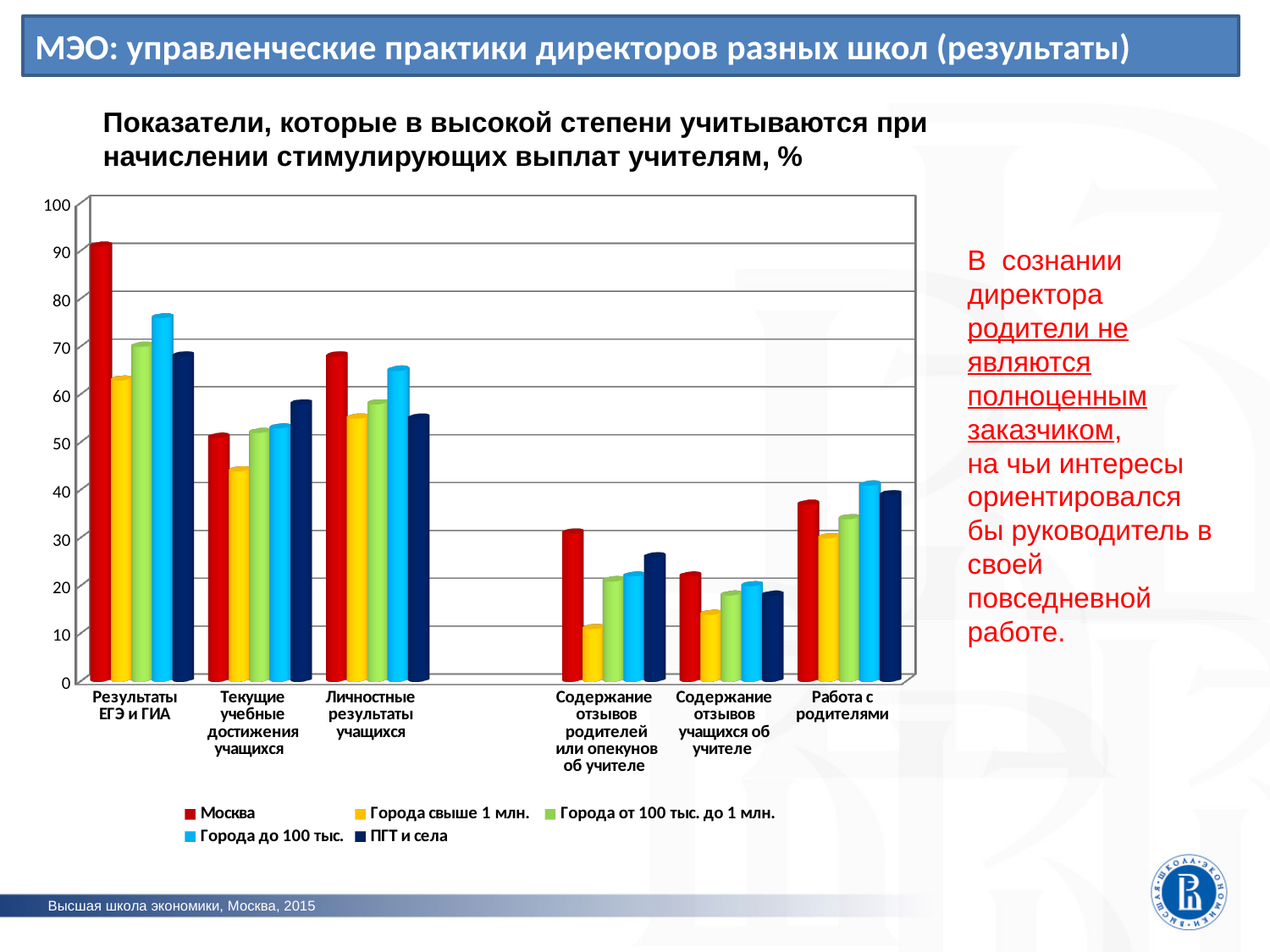
What kind of chart is shown on the slide? bar chart How many series does the legend list? 5 For which category is the value for Москва the lowest? Содержание отзывов учащихся об учителе Is the value for Москва in the category Результаты ЕГЭ и ГИА greater or less than 80? greater In the category Результаты ЕГЭ и ГИА, which series has the lowest value? Города свыше 1 млн. Is the value for Города свыше 1 млн. in the category Содержание отзывов родителей или опекунов об учителе greater or less than 20? less What colour represents the series Москва in the legend? red In the category Текущие учебные достижения учащихся, which series has the highest value? ПГТ и села In the category Работа с родителями, which is larger: the value for Города до 100 тыс. or the value for Города свыше 1 млн.? Города до 100 тыс. Is the value for ПГТ и села in the category Личностные результаты учащихся greater or less than 60? less For which category is the value for Москва the highest? Результаты ЕГЭ и ГИА How many categories are shown on the x axis? 6